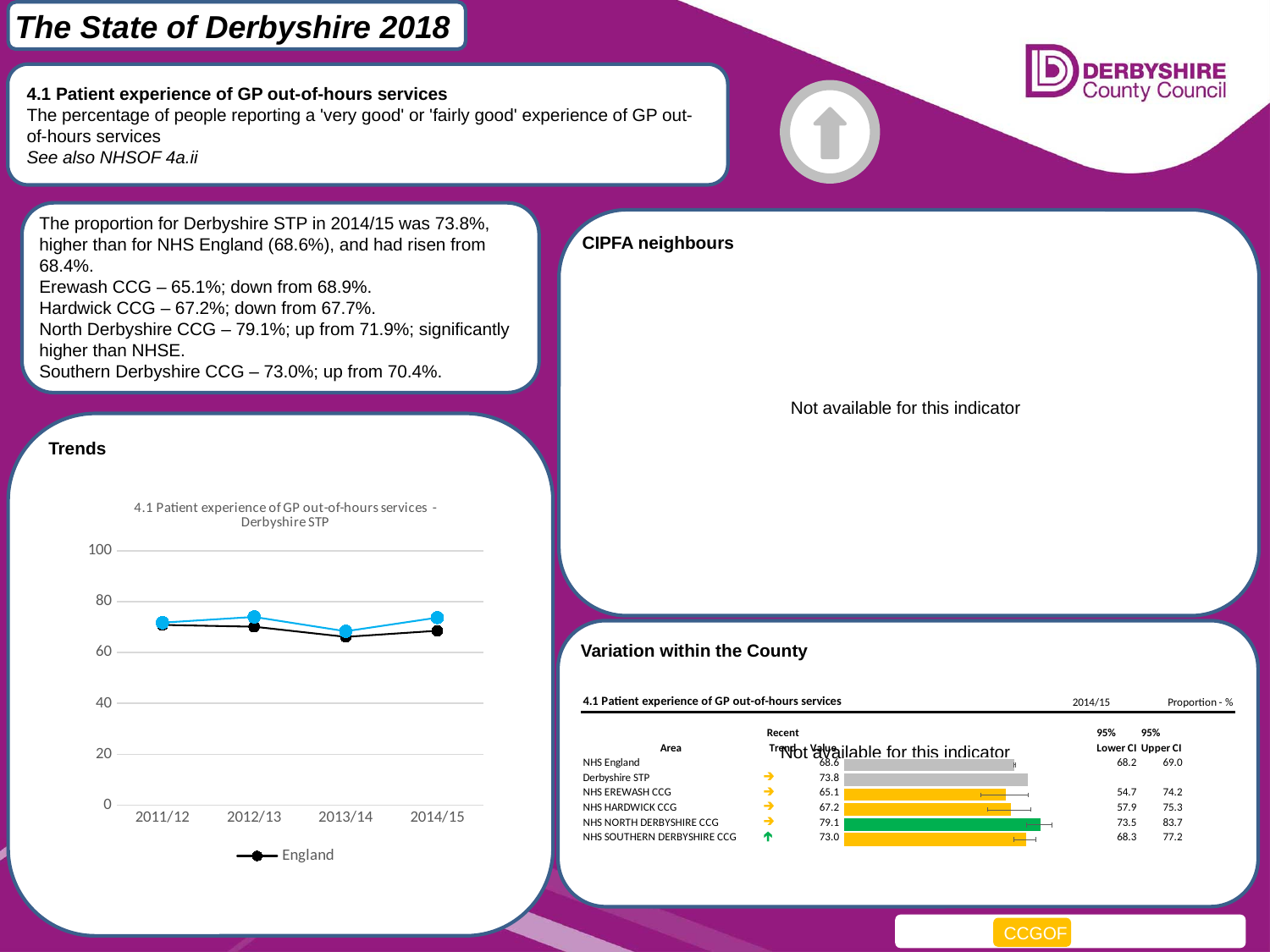
In the 'Variation within the County' chart, which area has the highest value? NHS NORTH DERBYSHIRE CCG What kind of chart is the 'Trends' chart for Derbyshire STP? line chart In the 'Variation within the County' chart, which area has the lowest value? NHS EREWASH CCG In the 'Variation within the County' chart, what is the 95% Upper CI for NHS NORTH DERBYSHIRE CCG? 83.7 In the 'Variation within the County' chart, what is the value for NHS NORTH DERBYSHIRE CCG? 79.1 In the 'Trends' line chart, is the England value for 2014/15 greater or less than 60? greater In the 'Variation within the County' chart, what is the value for Derbyshire STP? 73.8 In the 'Variation within the County' chart, which has the larger value, NHS HARDWICK CCG or NHS SOUTHERN DERBYSHIRE CCG? NHS SOUTHERN DERBYSHIRE CCG In the 'Variation within the County' chart, what is the difference between the values for NHS NORTH DERBYSHIRE CCG and NHS EREWASH CCG? 14.0 In the 'Variation within the County' chart, what is the value for NHS EREWASH CCG? 65.1 How many areas are listed in the 'Variation within the County' chart? 6 How many time periods are shown on the x axis of the 'Trends' line chart? 4